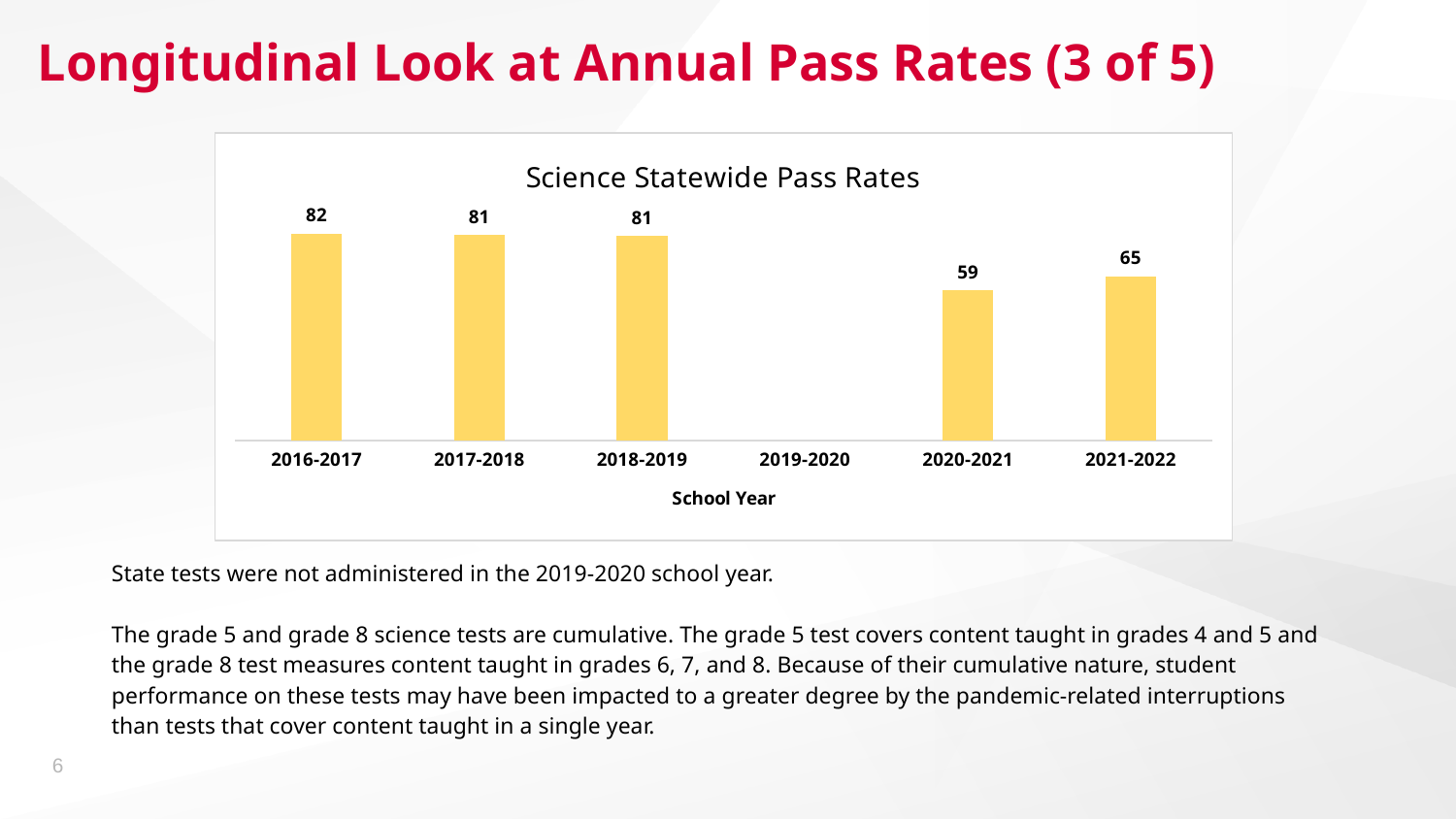
What is the title of the chart? Science Statewide Pass Rates Which school year with a plotted bar has the lowest science statewide pass rate? 2020-2021 What is the difference between the pass rates for 2021-2022 and 2020-2021? 6 How many school years are labeled on the x axis? 6 Which is larger, the pass rate for 2018-2019 or for 2021-2022? 2018-2019 What is the science statewide pass rate for 2016-2017? 82 Which school year has the highest science statewide pass rate? 2016-2017 What is the science statewide pass rate for 2021-2022? 65 What is the science statewide pass rate for 2020-2021? 59 What is the difference between the pass rates for 2016-2017 and 2020-2021? 23 Which school year has no bar plotted in the chart? 2019-2020 What type of chart is shown on the slide? Bar chart